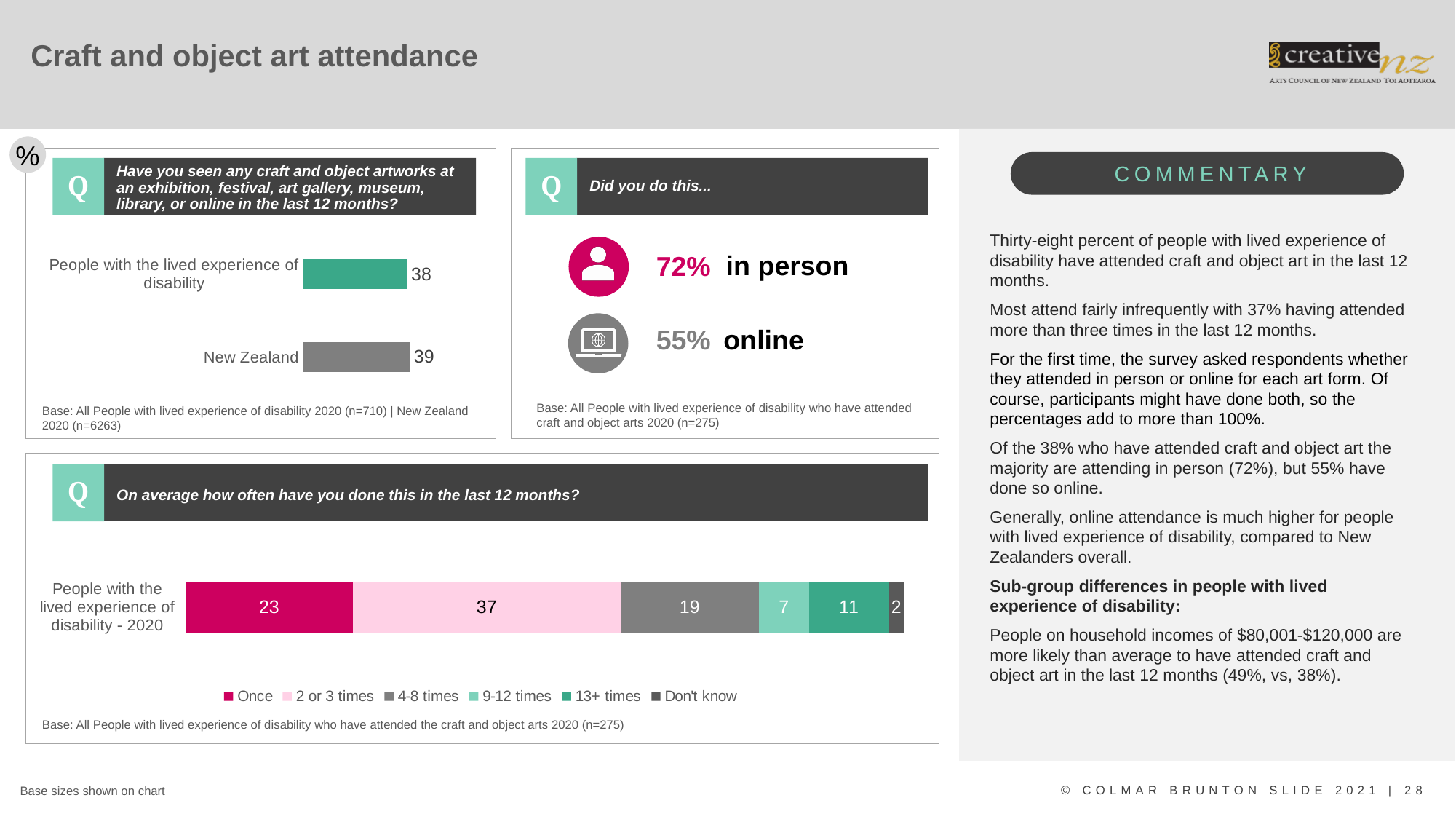
What kind of chart is the top-left chart on whether people have seen craft and object artworks in the last 12 months? Bar chart In the top-left chart on whether people have seen craft and object artworks in the last 12 months, what is the value for People with the lived experience of disability? 38 In the bottom chart on how often people have done this in the last 12 months, which segment has the highest value? 2 or 3 times In the top-left chart on whether people have seen craft and object artworks in the last 12 months, what is the value for New Zealand? 39 In the top-left chart on whether people have seen craft and object artworks in the last 12 months, what is the difference between the New Zealand value and the value for People with the lived experience of disability? 1 In the bottom chart on how often people have done this in the last 12 months, how many series does the legend list? 6 In the bottom chart on how often people have done this in the last 12 months, what is the value for 13+ times? 11 In the bottom chart on how often people have done this in the last 12 months, which is larger: the value for Once or the value for 9-12 times? Once In the bottom chart on how often people have done this in the last 12 months, what is the difference between the Once value and the 4-8 times value? 4 In the bottom chart on how often people have done this in the last 12 months, which segment has the lowest value? Don't know In the bottom chart on how often people have done this in the last 12 months, what is the value for 2 or 3 times? 37 In the top-left chart on whether people have seen craft and object artworks in the last 12 months, how many categories are shown? 2